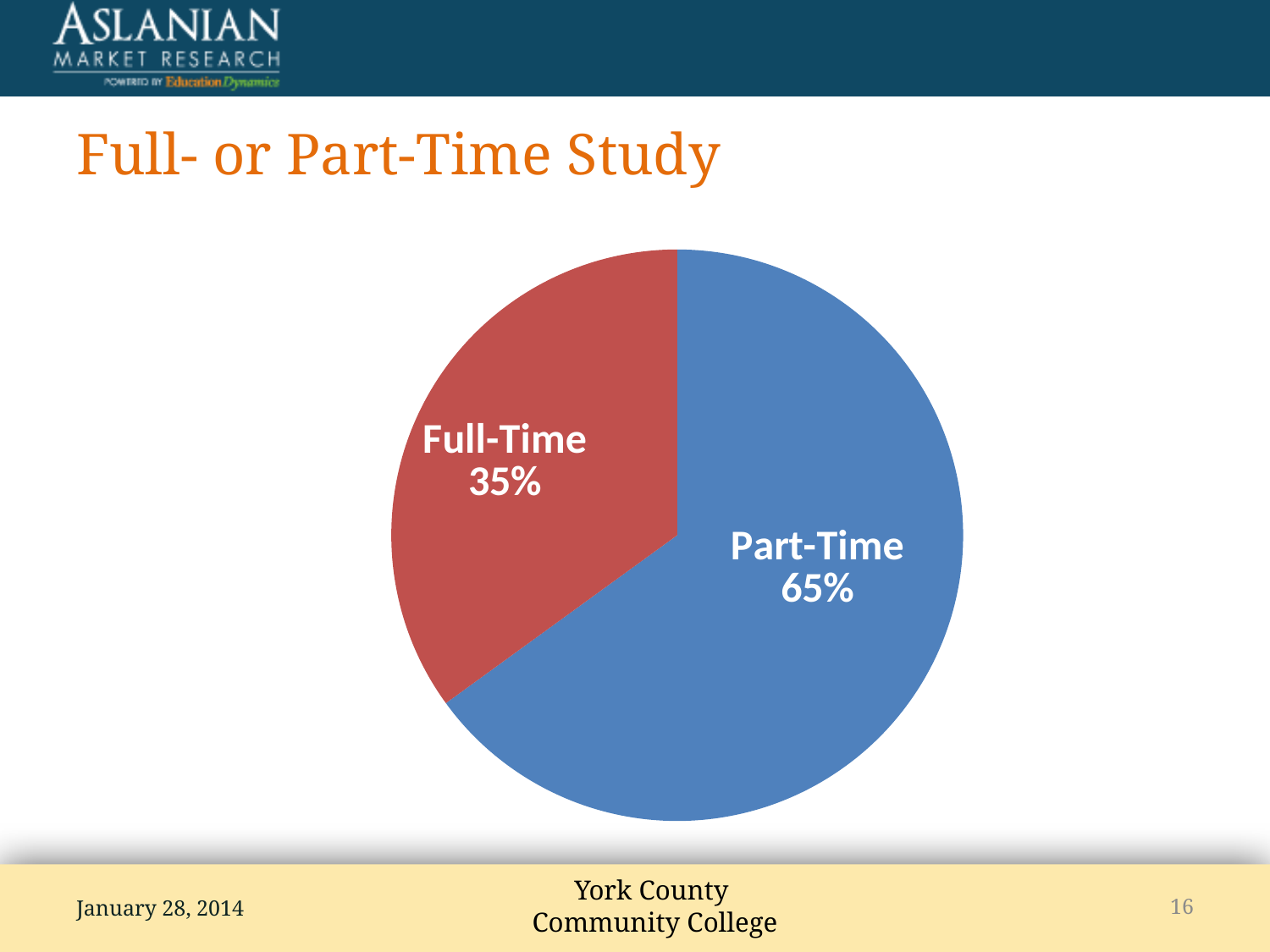
How many slices does the pie chart have? 2 What percentage of students study full-time? 35% What percentage of students study part-time? 65% Which category has the smallest share of the pie? Full-Time Which category has the largest share of the pie? Part-Time What colour is the Part-Time slice? blue What is the title of the slide containing the chart? Full- or Part-Time Study Which is larger, the Full-Time share or the Part-Time share? Part-Time What is the difference in percentage points between Part-Time and Full-Time? 30 What share of the pie does the Full-Time slice represent? 35% What kind of chart is shown on the slide? pie chart